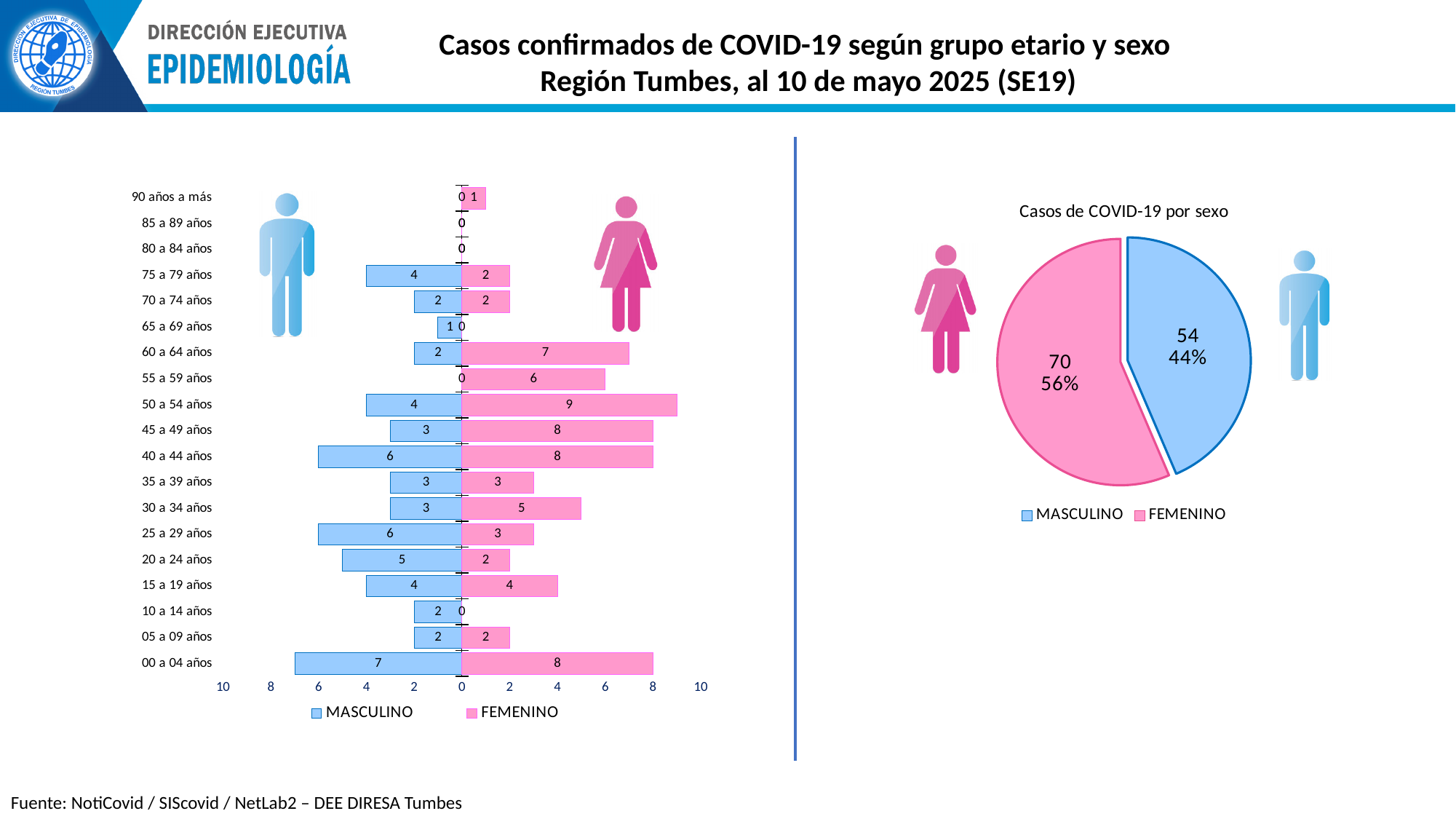
In the left bar chart, how many series does the legend list? 2 In the left bar chart, which is larger for 25 a 29 años, MASCULINO or FEMENINO? MASCULINO In the left bar chart, how many age groups are listed? 19 In the pie chart 'Casos de COVID-19 por sexo', what share of cases is MASCULINO? 44% What kind of chart is the chart on the left side of the slide? Bar chart In the left bar chart, how many FEMENINO cases are in the 50 a 54 años group? 9 In the left bar chart, what is the difference between the FEMENINO and MASCULINO values for 60 a 64 años? 5 What is the title of the pie chart on the right side of the slide? Casos de COVID-19 por sexo In the left bar chart, which age group has the highest FEMENINO value? 50 a 54 años In the pie chart 'Casos de COVID-19 por sexo', how many FEMENINO cases are shown? 70 In the left bar chart, how many MASCULINO cases are in the 00 a 04 años group? 7 In the pie chart 'Casos de COVID-19 por sexo', what is the total number of cases across both slices? 124